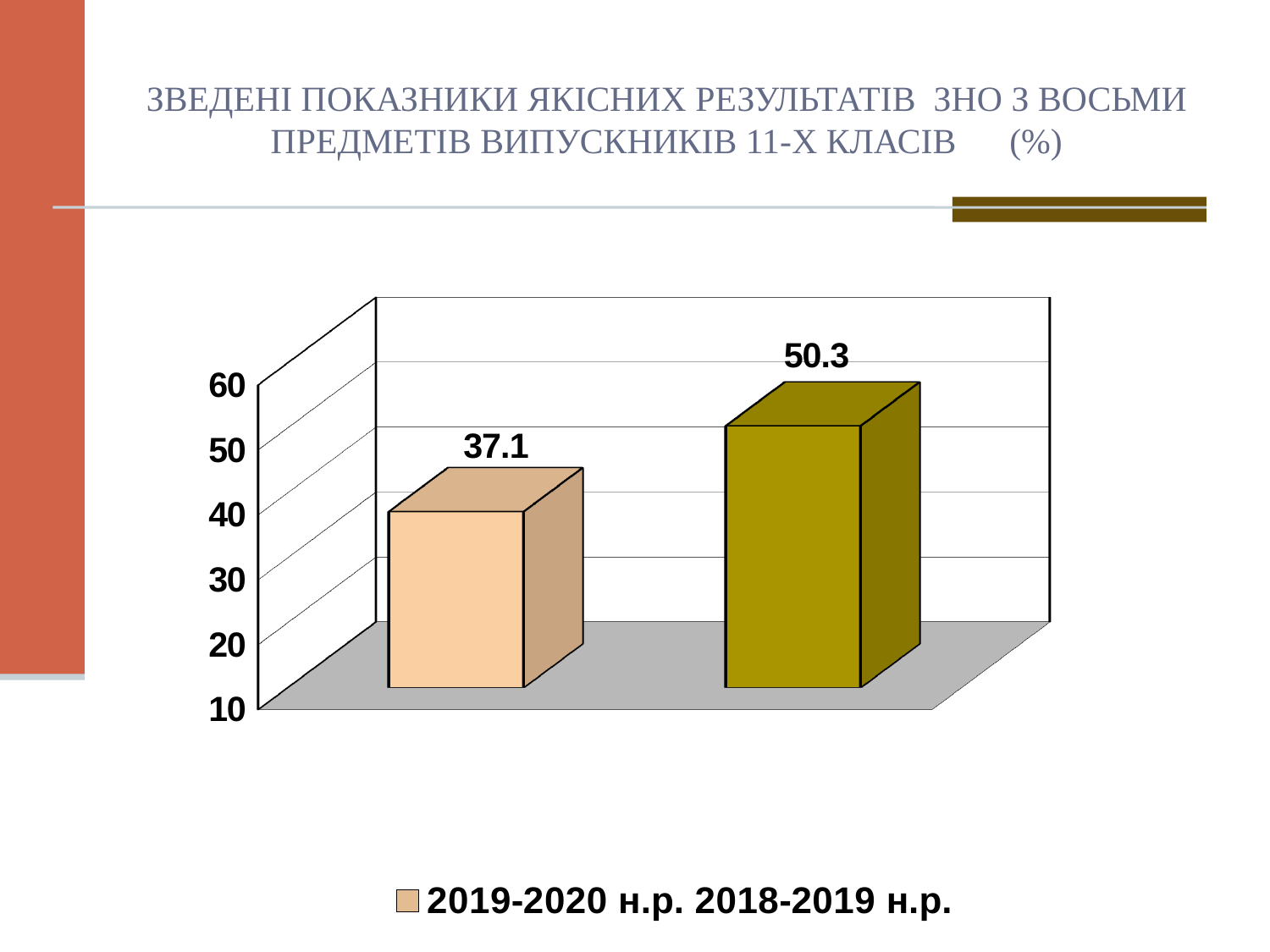
What colour is the legend swatch next to '2019-2020 н.р.'? Tan (light orange) Which bar has the lowest value? The tan bar on the left (37.1) What value is labelled on the olive bar on the right of the chart? 50.3 What kind of chart is shown on the slide? Bar chart What is the difference between the two bar values, 50.3 and 37.1? 13.2 How many bars are plotted in the chart? 2 Which bar has the highest value? The olive bar on the right (50.3) Is the value of the left tan bar greater or less than 40? less Is the value of the right olive bar greater or less than 40? greater What value is labelled on the tan bar (2019-2020 н.р.)? 37.1 Which is larger: the value of the left tan bar or the right olive bar? The right olive bar What is the highest tick value shown on the vertical axis? 60